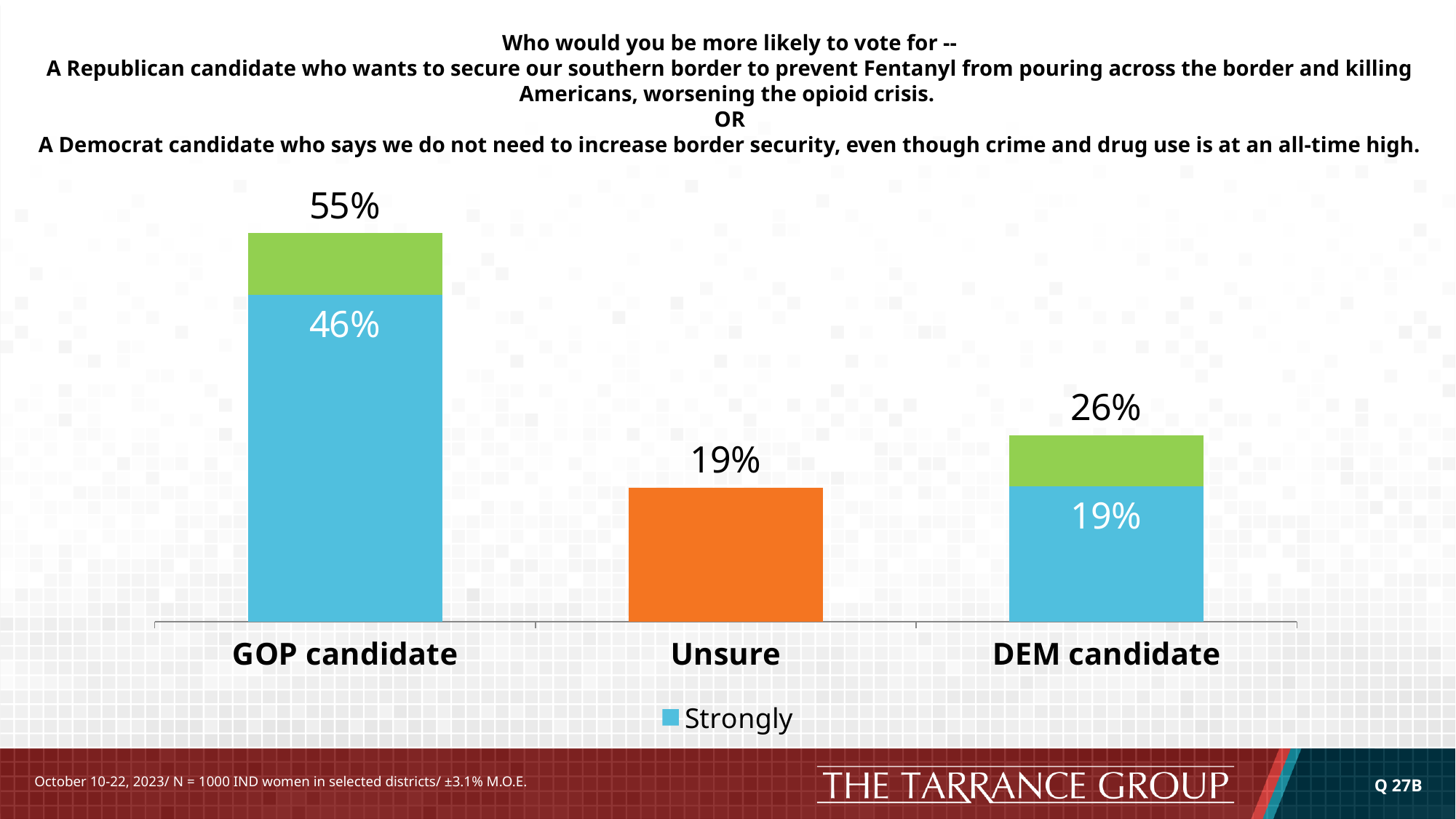
What is the total value shown for GOP candidate? 55% What is the total value shown for DEM candidate? 26% What is the difference between the Strongly values for GOP candidate and DEM candidate? 27% What is the difference between the GOP candidate total and the DEM candidate total? 29% Which category has the highest total value? GOP candidate What is the Strongly value for DEM candidate? 19% Which category has the lowest total value? Unsure What is the Strongly value for GOP candidate? 46% What is the value shown for Unsure? 19% What kind of chart is shown on the slide? Bar chart How many categories are shown on the x axis? 3 Which is larger, the DEM candidate total or the Unsure value? DEM candidate total